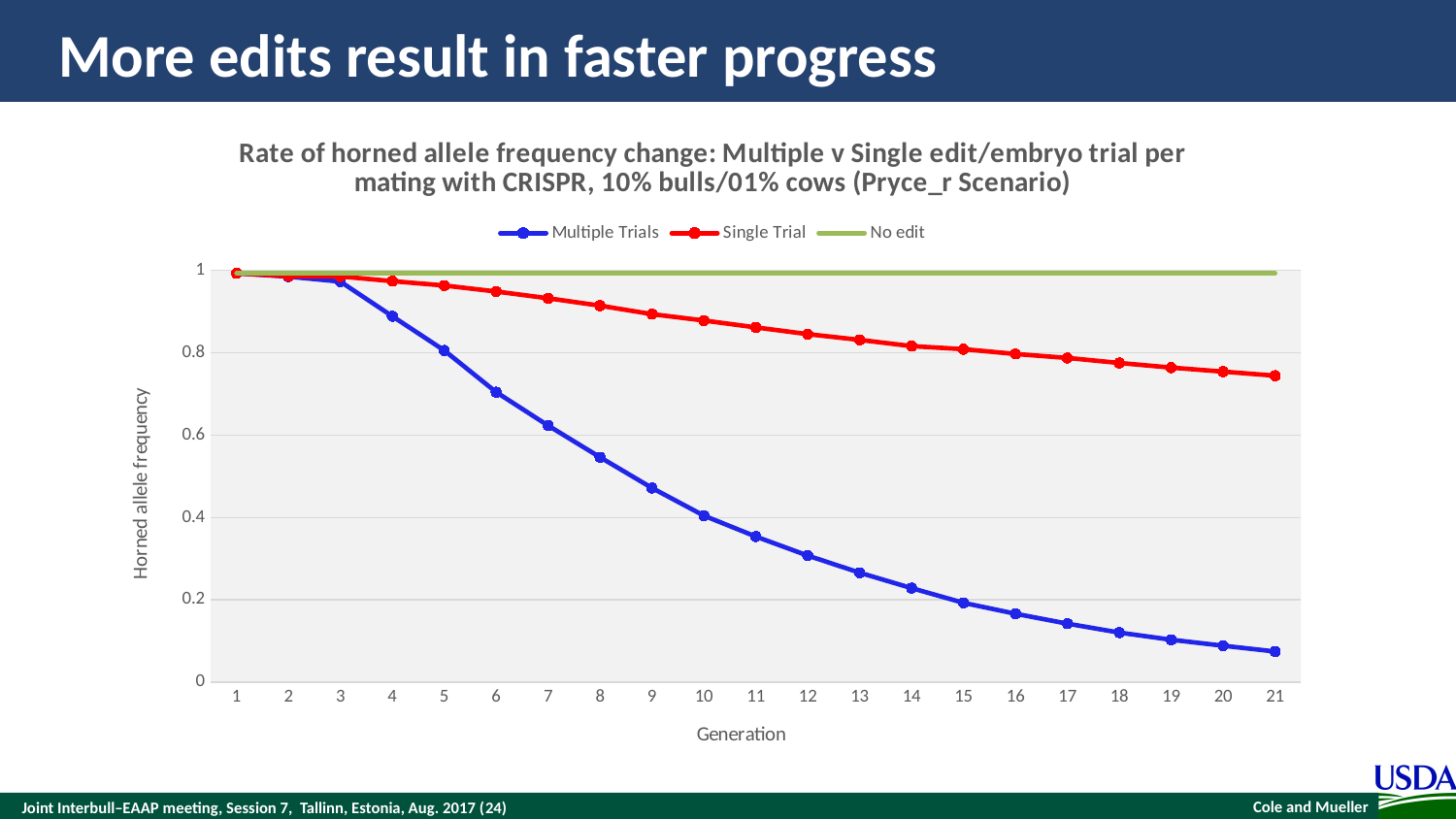
Is the Multiple Trials value at generation 5 greater or less than 0.6? greater At generation 15, which series has the higher value, Single Trial or Multiple Trials? Single Trial Does the No edit series rise, fall, or stay flat as generation increases? Stay flat How many series does the legend list? 3 Is the Single Trial value at generation 21 greater or less than 0.6? greater How many generations are plotted along the x axis? 21 Which series has the lowest value at generation 21? Multiple Trials Is the Multiple Trials value at generation 10 greater or less than 0.6? less What kind of chart is shown on the slide? Line chart Does the Single Trial series rise or fall as generation increases? Fall What is the title of the y axis? Horned allele frequency Does the Multiple Trials series rise or fall as generation increases? Fall